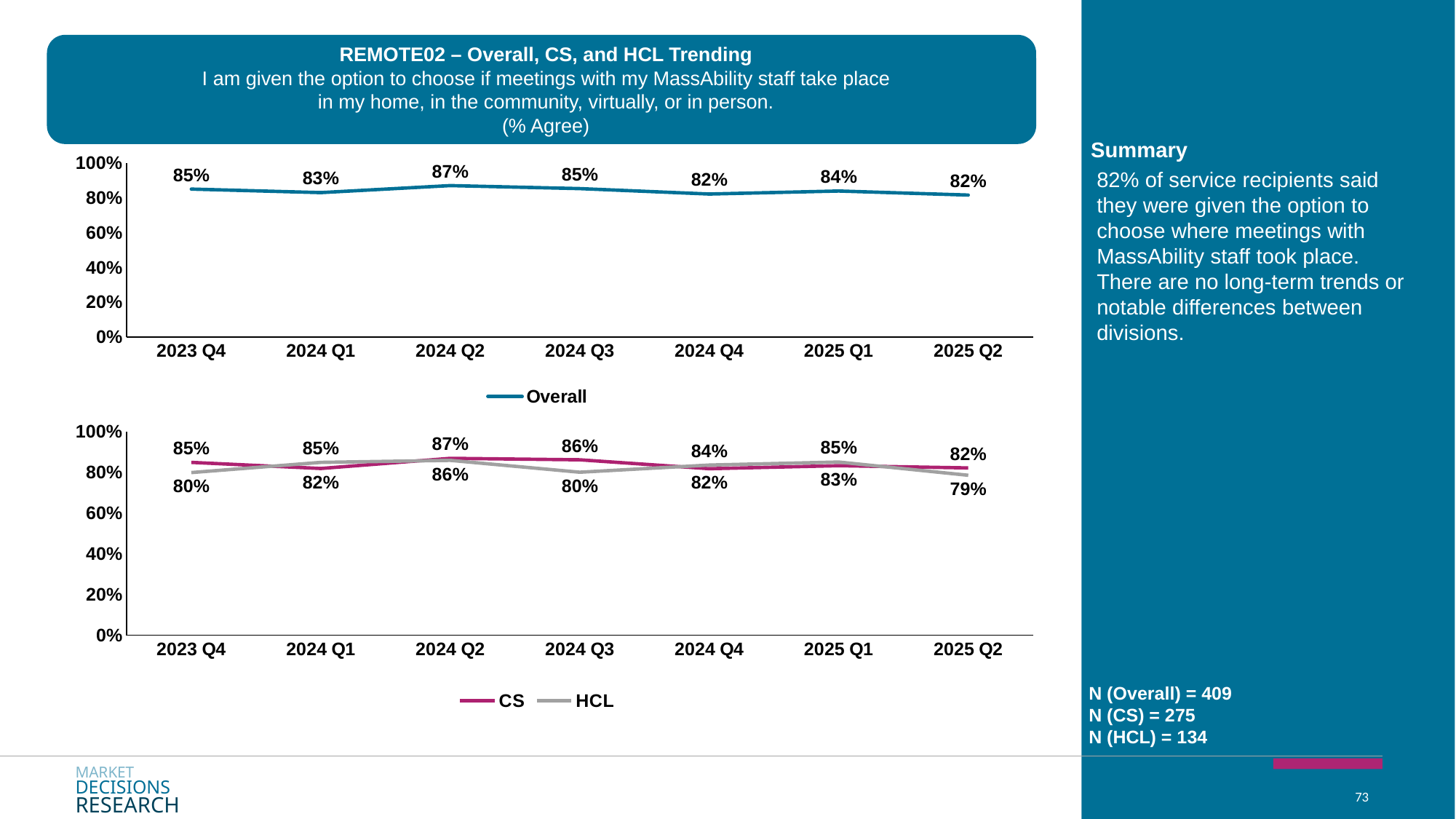
In the bottom chart, which series has the higher value in 2024 Q3, CS or HCL? CS In the top chart (Overall), which quarter has the highest value? 2024 Q2 In the top chart (Overall), is the value for 2024 Q1 greater or less than 80%? greater In the top chart (Overall), what is the value for 2024 Q4? 82% In the top chart (Overall), what is the value for 2024 Q2? 87% In the bottom chart (CS and HCL), what is the CS value for 2023 Q4? 85% In the bottom chart, what is the difference between the CS and HCL values in 2023 Q4? 5 percentage points How many quarters are plotted in the top chart (Overall)? 7 How many series does the legend of the bottom chart list? 2 In the top chart (Overall), what is the difference between the 2024 Q2 value and the 2025 Q2 value? 5 percentage points In the bottom chart (CS and HCL), what is the HCL value for 2025 Q2? 79% What kind of chart is the top chart (Overall)? Line chart